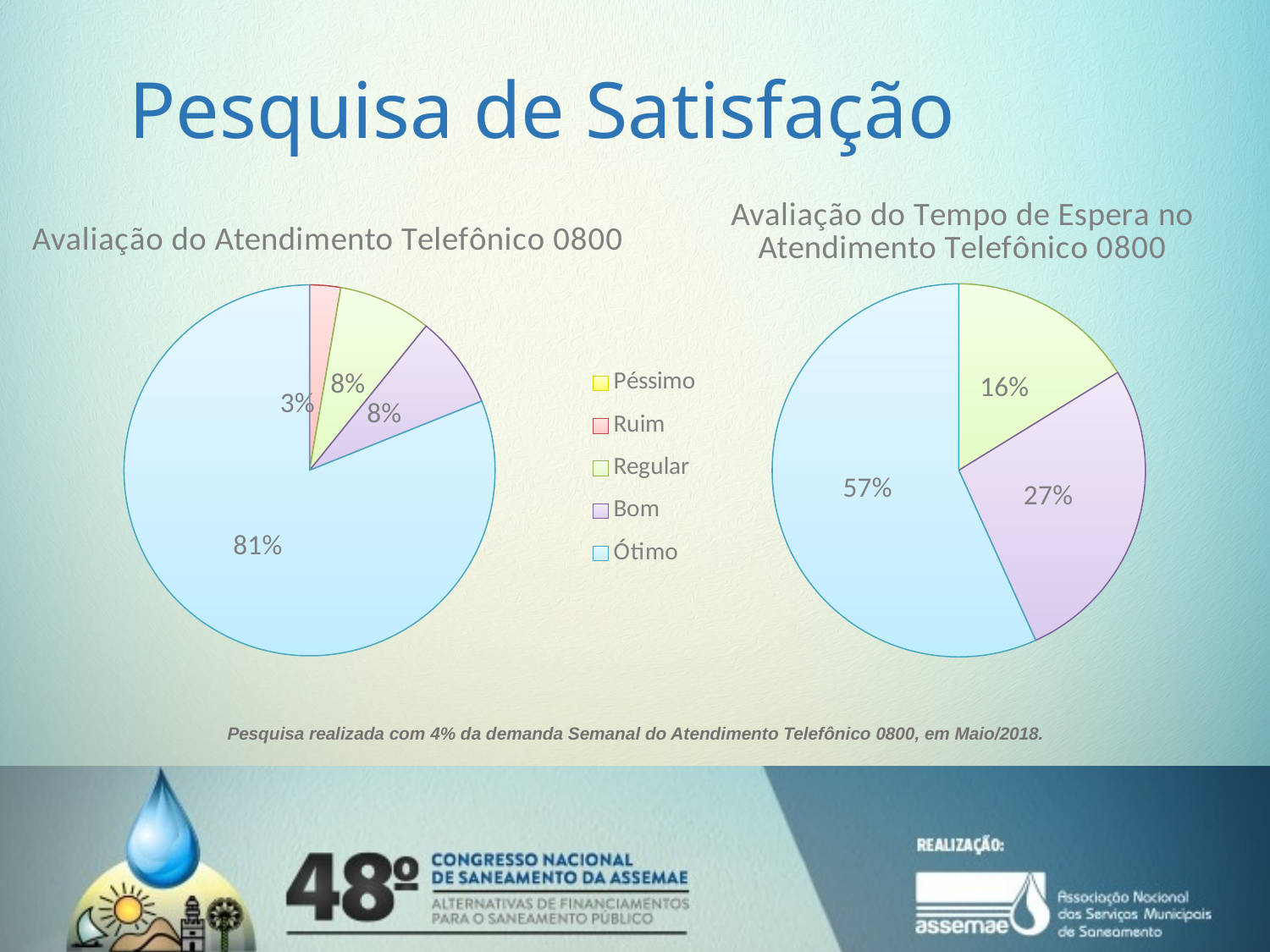
In the chart titled 'Avaliação do Tempo de Espera no Atendimento Telefônico 0800', what percentage is shown for Ótimo? 57% In the chart titled 'Avaliação do Atendimento Telefônico 0800', which category has the largest slice? Ótimo In the chart titled 'Avaliação do Tempo de Espera no Atendimento Telefônico 0800', which labelled category has the smallest slice? Regular What type of chart is used for 'Avaliação do Atendimento Telefônico 0800'? Pie chart How many entries does the legend between the two charts list? 5 In the chart titled 'Avaliação do Atendimento Telefônico 0800', what percentage is shown for Ótimo? 81% In the chart titled 'Avaliação do Tempo de Espera no Atendimento Telefônico 0800', which category has the largest slice? Ótimo In the chart titled 'Avaliação do Tempo de Espera no Atendimento Telefônico 0800', what percentage is shown for Bom? 27% In the chart titled 'Avaliação do Tempo de Espera no Atendimento Telefônico 0800', what is the difference in percentage points between Ótimo and Bom? 30 percentage points In the chart titled 'Avaliação do Tempo de Espera no Atendimento Telefônico 0800', what percentage is shown for Regular? 16% In the chart titled 'Avaliação do Atendimento Telefônico 0800', what percentage is shown for Ruim? 3% In the chart titled 'Avaliação do Tempo de Espera no Atendimento Telefônico 0800', which is larger, Bom or Regular? Bom